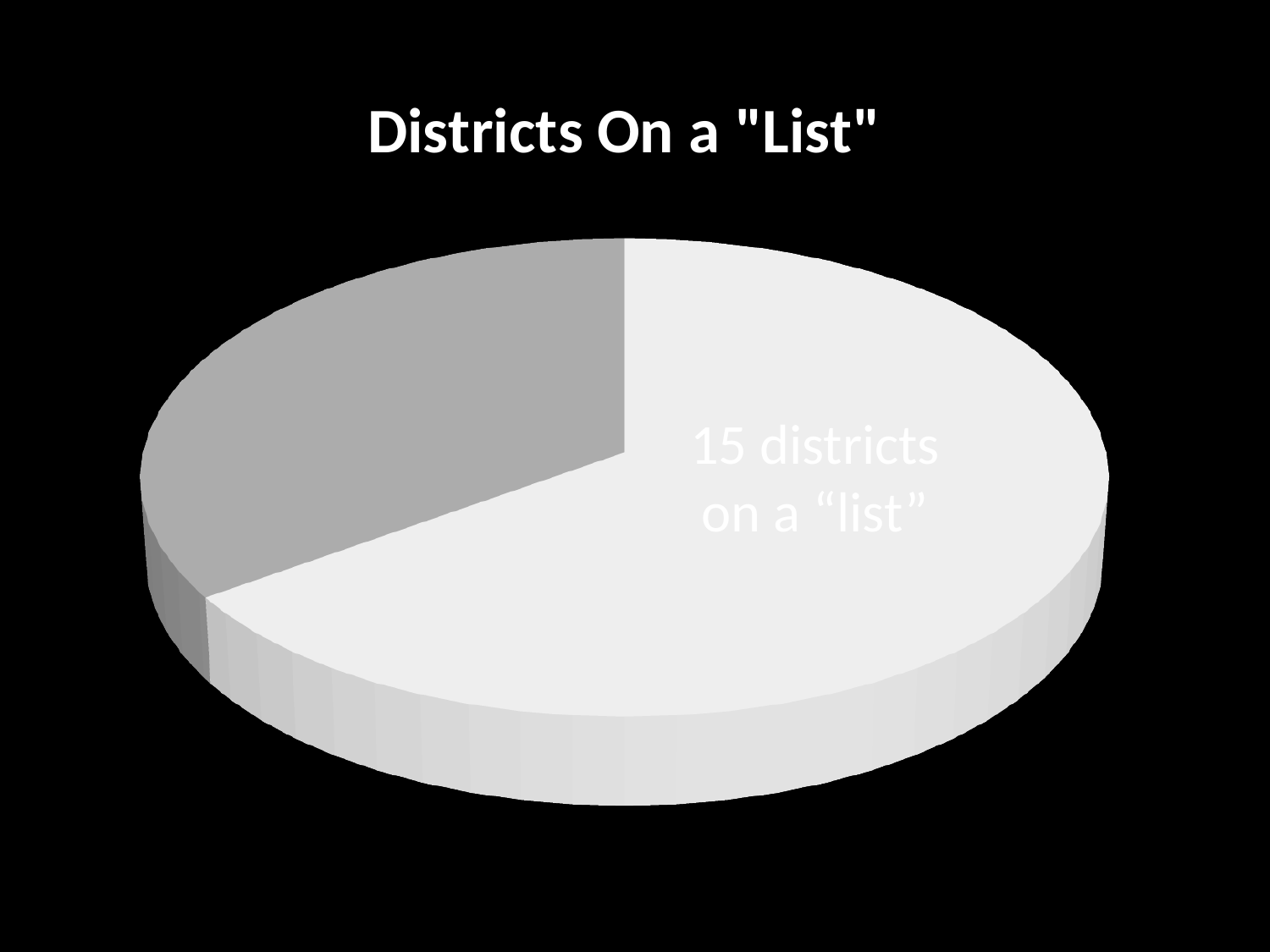
Does the slice labelled "15 districts on a 'list'" take up more or less than half of the pie? More Does the chart have a legend? No Which slice is larger: the light slice labelled "15 districts on a 'list'" or the unlabelled dark grey slice? The light slice labelled "15 districts on a 'list'" Which slice of the pie is the smallest? The unlabelled dark grey slice What kind of chart is shown on the slide? Pie chart How many districts does the label on the large slice say are on a "list"? 15 districts What is the title of the chart? Districts On a "List" How many slices does the pie chart have? 2